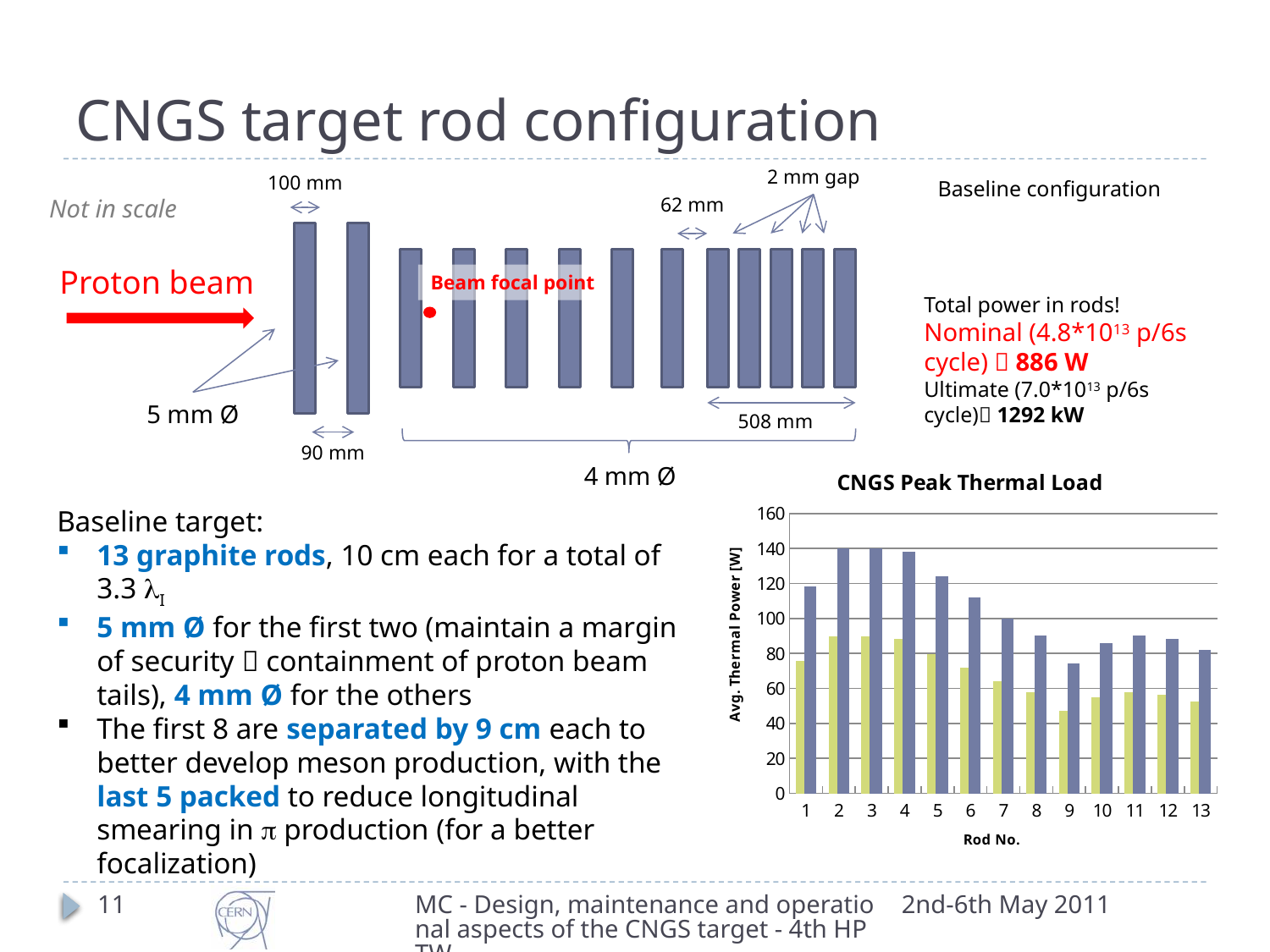
In the CNGS Peak Thermal Load chart, which rod number has the lowest value among the taller blue-grey bars? 9 In the CNGS Peak Thermal Load chart, is the green bar for rod 2 greater or less than 80? greater How many rod numbers are shown on the x axis of the CNGS Peak Thermal Load chart? 13 In the CNGS Peak Thermal Load chart, which is larger: the blue-grey bar for rod 2 or the blue-grey bar for rod 13? rod 2 In the CNGS Peak Thermal Load chart, is the blue-grey bar for rod 1 greater or less than 100? greater In the CNGS Peak Thermal Load chart, do the blue-grey bars rise or fall from rod 4 to rod 9? fall In the CNGS Peak Thermal Load chart, is the green bar for rod 9 greater or less than 60? less What is the y-axis label of the CNGS Peak Thermal Load chart? Avg. Thermal Power [W] What kind of chart is the CNGS Peak Thermal Load chart? bar chart In the CNGS Peak Thermal Load chart, which rod number has the lowest value among the shorter green bars? 9 What is the title of the chart on the slide? CNGS Peak Thermal Load